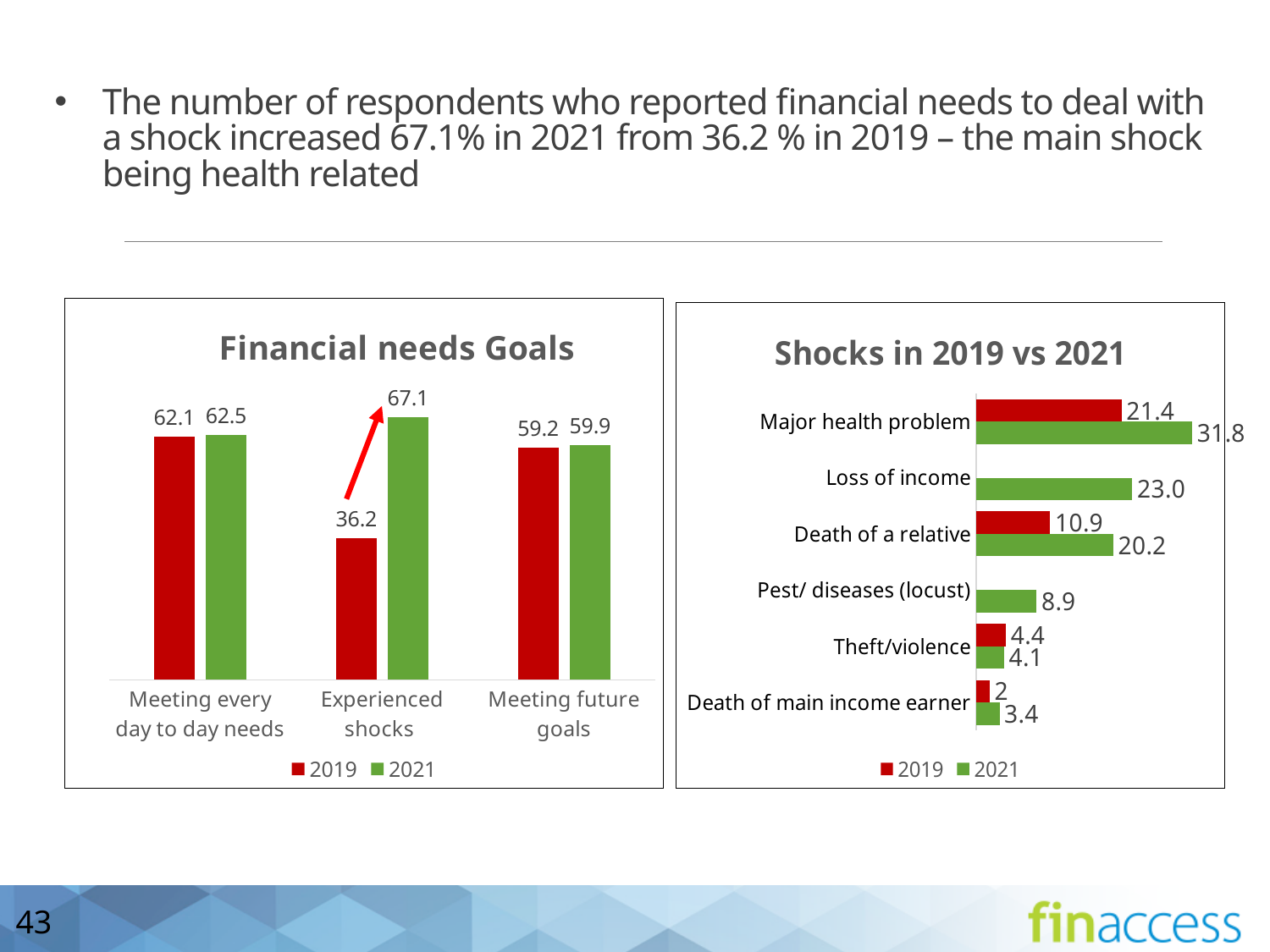
In the 'Financial needs Goals' chart, what is the 2019 value for Meeting every day to day needs? 62.1 In the 'Financial needs Goals' chart, how many categories are shown on the x axis? 3 In the 'Shocks in 2019 vs 2021' chart, what is the difference between the 2021 and 2019 values for Major health problem? 10.4 In the 'Financial needs Goals' chart, what is the 2021 value for Experienced shocks? 67.1 How many series does the legend of the 'Shocks in 2019 vs 2021' chart list? 2 In the 'Financial needs Goals' chart, which category has the lowest 2019 value? Experienced shocks In the 'Shocks in 2019 vs 2021' chart, what is the 2019 value for Death of a relative? 10.9 In the 'Shocks in 2019 vs 2021' chart, what is the 2021 value for Loss of income? 23.0 In the 'Shocks in 2019 vs 2021' chart, which shock has the highest 2021 value? Major health problem In the 'Shocks in 2019 vs 2021' chart, what is the 2021 value for Major health problem? 31.8 In the 'Financial needs Goals' chart, what is the difference between the 2021 and 2019 values for Experienced shocks? 30.9 In the 'Shocks in 2019 vs 2021' chart, which is larger for Theft/violence: the 2019 value or the 2021 value? 2019